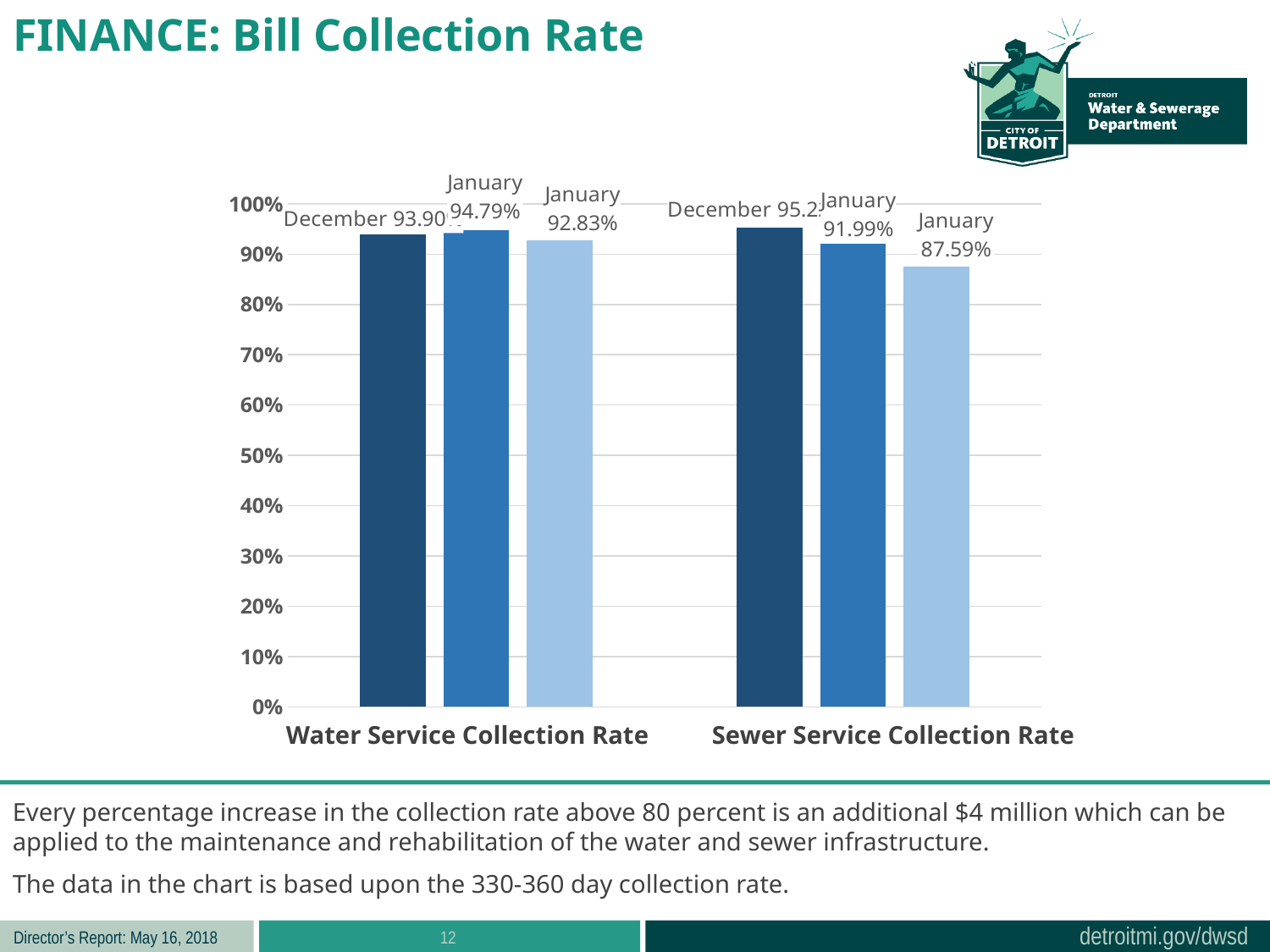
Which is larger: the rightmost (lightest blue) bar for Water Service Collection Rate or the rightmost bar for Sewer Service Collection Rate? Water Service Collection Rate What is the value of the lightest blue (rightmost) bar in the Sewer Service Collection Rate group? 87.59% What is the difference between the middle bar (91.99%) and the rightmost bar (87.59%) in the Sewer Service Collection Rate group? 4.40 percentage points Which bar on the chart has the lowest value? The rightmost (January 87.59%) bar in the Sewer Service Collection Rate group What is the value of the lightest blue (rightmost) bar in the Water Service Collection Rate group? 92.83% In the Sewer Service Collection Rate group, do the bars rise or fall from left to right? Fall What is the difference between the middle bar (94.79%) and the rightmost bar (92.83%) in the Water Service Collection Rate group? 1.96 percentage points What is the value of the middle (medium blue) bar in the Sewer Service Collection Rate group? 91.99% What is the value of the middle (medium blue) bar in the Water Service Collection Rate group? 94.79% How many categories are shown on the x axis of the chart? 2 Is the December value for Sewer Service Collection Rate greater or less than 90%? greater What kind of chart is shown on the slide? Bar chart